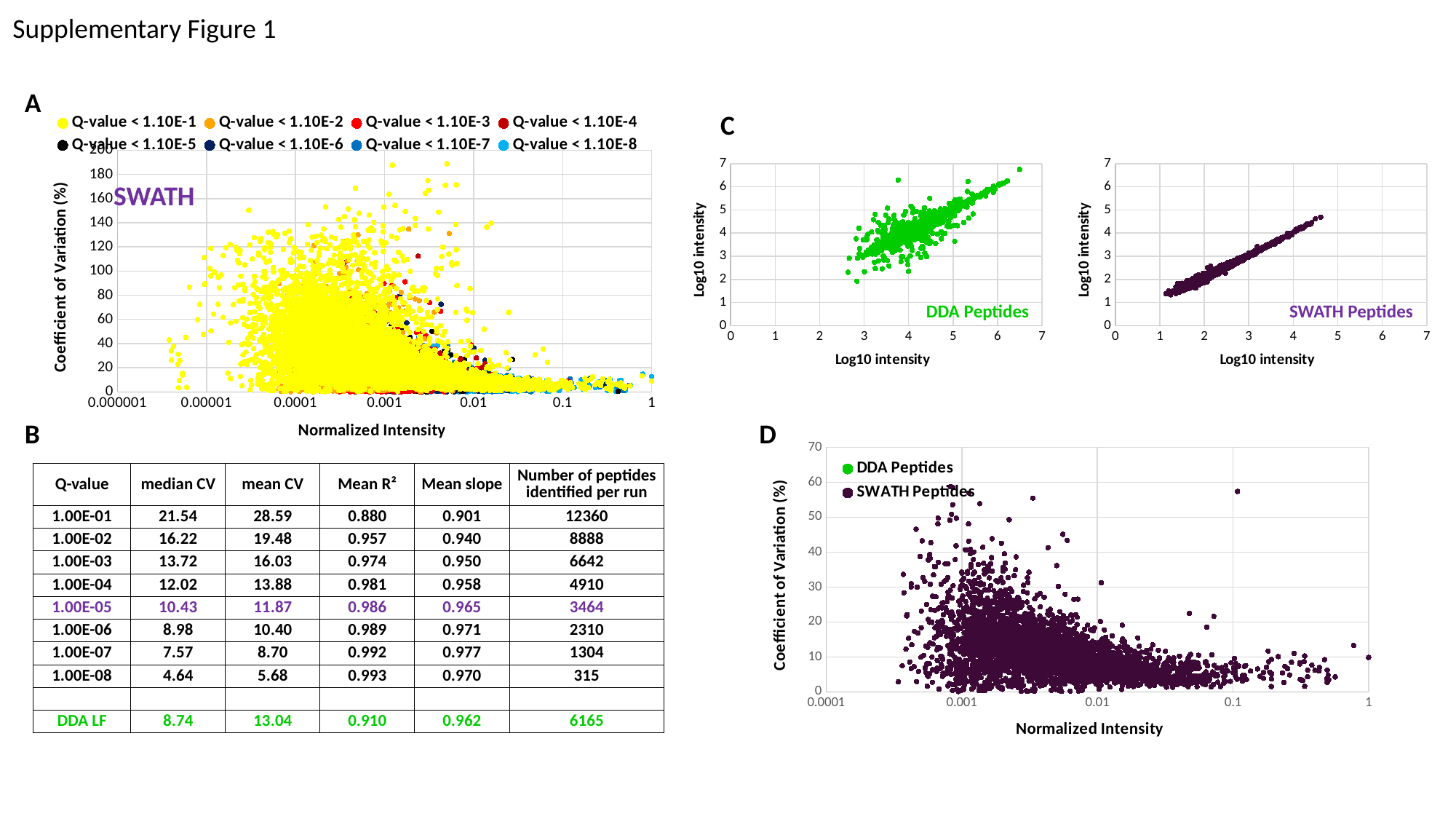
In panel D, what kind of chart is shown? scatter chart In panel A (SWATH), how many series does the legend list? 8 In panel D, how many series does the legend list? 2 In panel C, right chart (SWATH Peptides), do the points rise or fall along the x axis? rise In panel D, is the highest Coefficient of Variation value plotted greater or less than 50? greater In panel A (SWATH), what kind of chart is shown? scatter chart In panel C, left chart (DDA Peptides), do the points rise or fall along the x axis? rise In panel A (SWATH), is the highest Coefficient of Variation value plotted greater or less than 160? greater In panel A (SWATH), do the Coefficient of Variation values generally rise or fall as Normalized Intensity increases toward 1? fall In panel C, which series is plotted in the left chart? DDA Peptides In panel A (SWATH), what is the label of the x axis? Normalized Intensity In panel A (SWATH), which colour is used for the Q-value < 1.10E-1 series? yellow